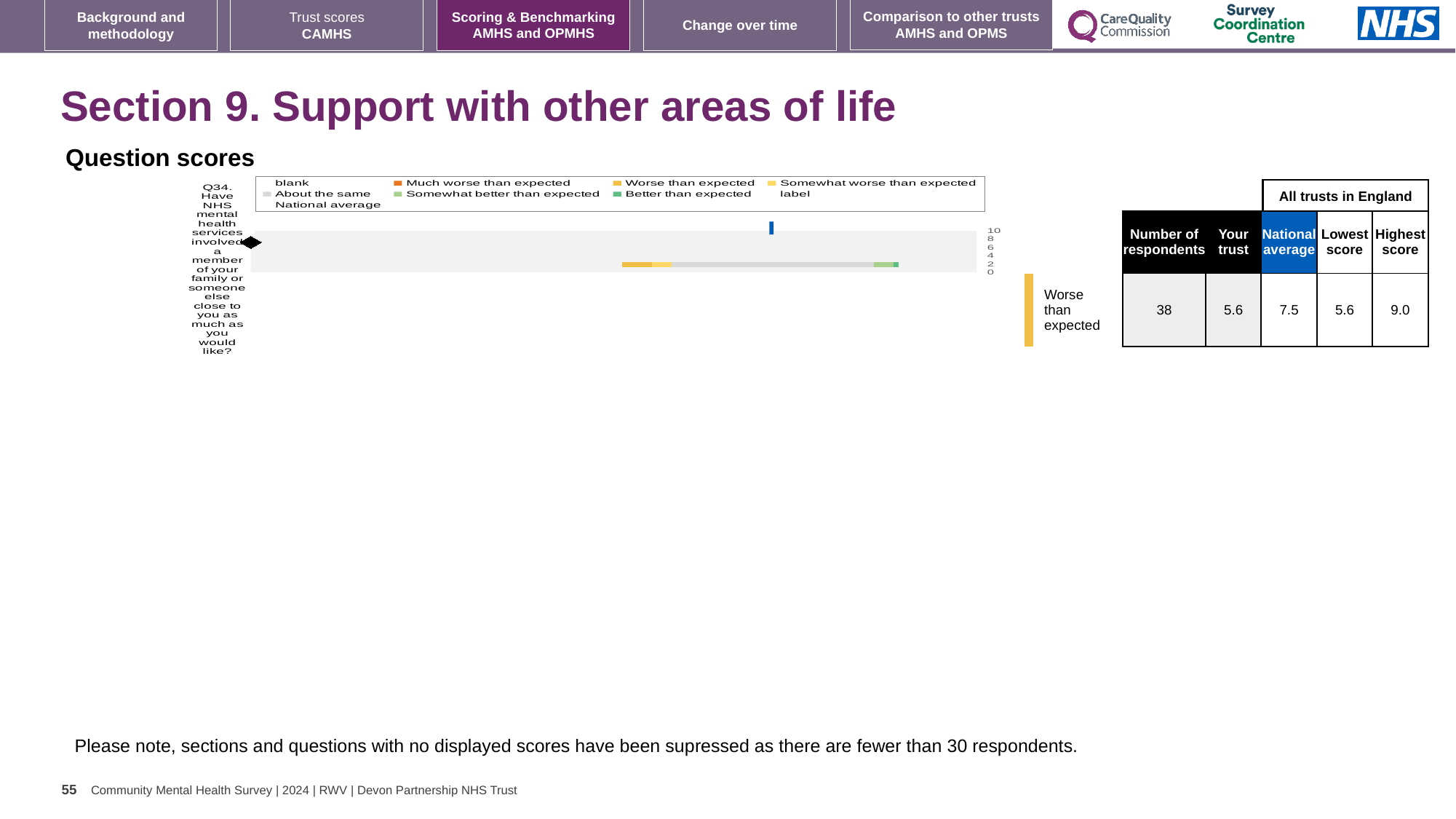
What is the difference between the national average and the 'Your trust' score for Q34? 1.9 What benchmark rating is given for Q34 next to the chart? Worse than expected What is the lowest score among all trusts in England for Q34? 5.6 What is the number of respondents for Q34? 38 How many questions (categories) are plotted in the Question scores chart? 1 What is the highest score among all trusts in England for Q34? 9.0 What is the 'Your trust' score for Q34? 5.6 What is the highest value shown on the chart's axis? 10 What is the national average score for Q34? 7.5 What kind of chart is shown under 'Question scores'? bar chart Which is larger for Q34, the 'Your trust' score or the national average? national average Which legend entry is shown in orange in the Question scores chart? Much worse than expected